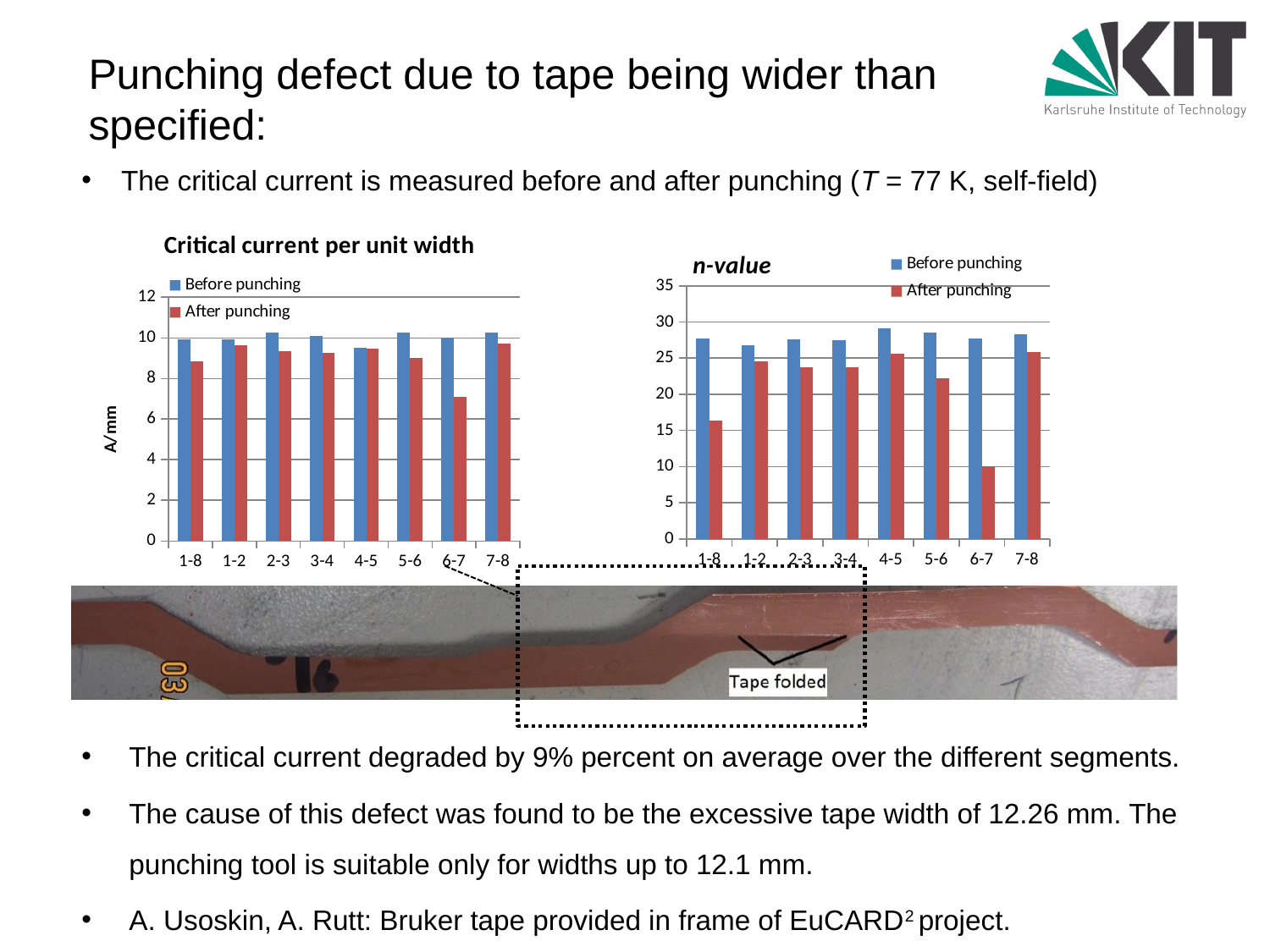
In the "n-value" chart, is the "After punching" value for 1-8 greater or less than 20? less In the "Critical current per unit width" chart, which is larger: the "After punching" value for 6-7 or for 7-8? 7-8 In the "Critical current per unit width" chart, is the "After punching" value for 6-7 greater or less than 8? less In the "n-value" chart, which is larger: the "After punching" value for 1-8 or for 6-7? 1-8 In the "n-value" chart, which category has the lowest "After punching" value? 6-7 What is the y-axis label of the "Critical current per unit width" chart? A/mm How many categories are shown on the x axis of the "n-value" chart? 8 In the "n-value" chart, is the "After punching" value for 6-7 greater or less than 15? less How many series does the legend of the "Critical current per unit width" chart list? 2 In the "Critical current per unit width" chart, which category has the lowest "After punching" value? 6-7 What type of chart is the "Critical current per unit width" chart? bar chart